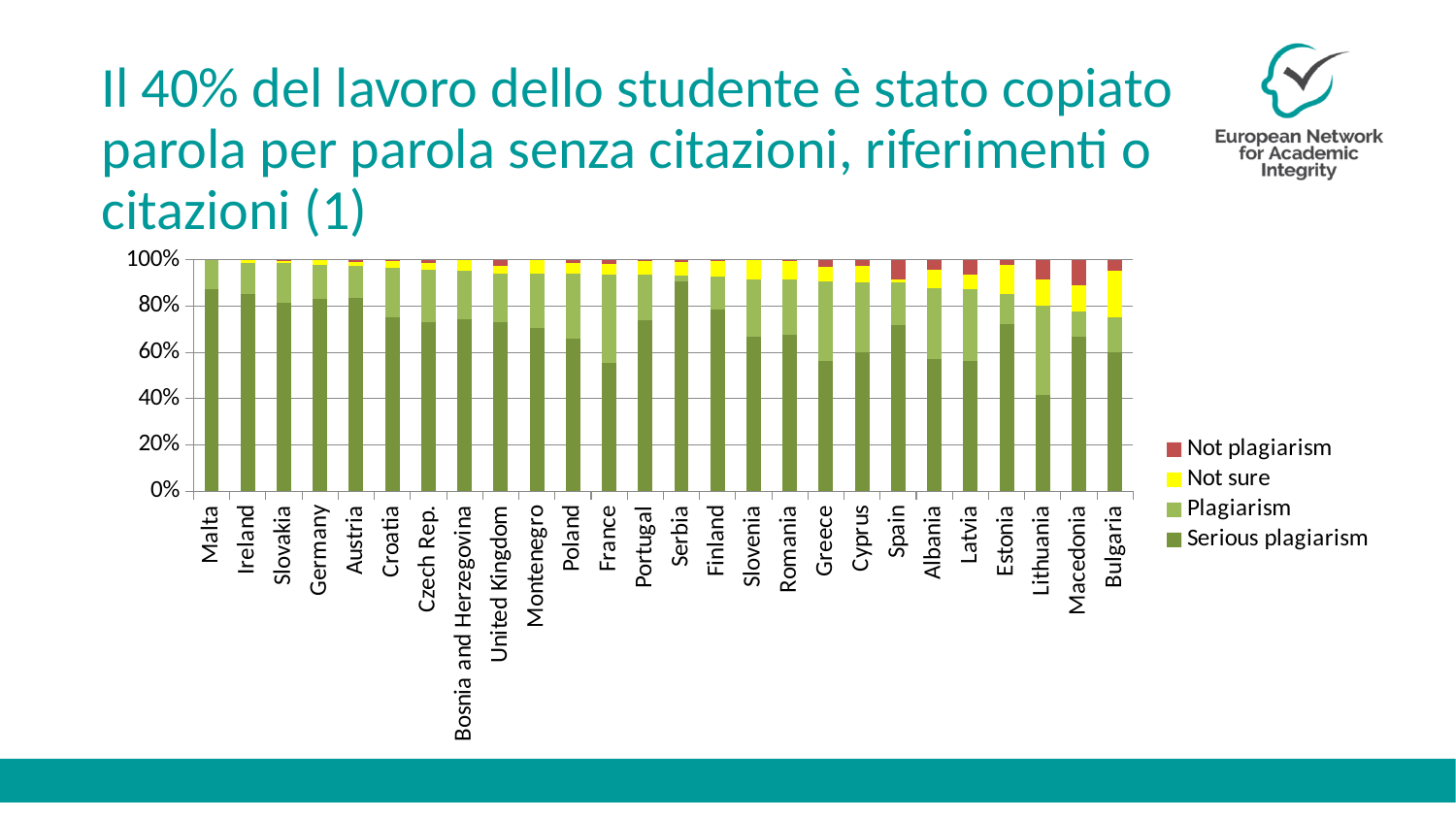
Which country has the lowest share of 'Serious plagiarism'? Lithuania Which has a larger 'Serious plagiarism' share, Germany or Macedonia? Germany Which legend entry is shown in red? Not plagiarism Is the 'Serious plagiarism' value for Serbia greater or less than 80%? greater Which has a larger 'Serious plagiarism' share, Malta or Lithuania? Malta Is the 'Serious plagiarism' value for Lithuania greater or less than 60%? less Is the 'Serious plagiarism' value for Malta greater or less than 80%? greater How many countries are shown on the x axis of the chart? 26 What kind of chart is shown on the slide? bar chart What do the stacked segments of each country's bar add up to? 100% How many series does the legend list? 4